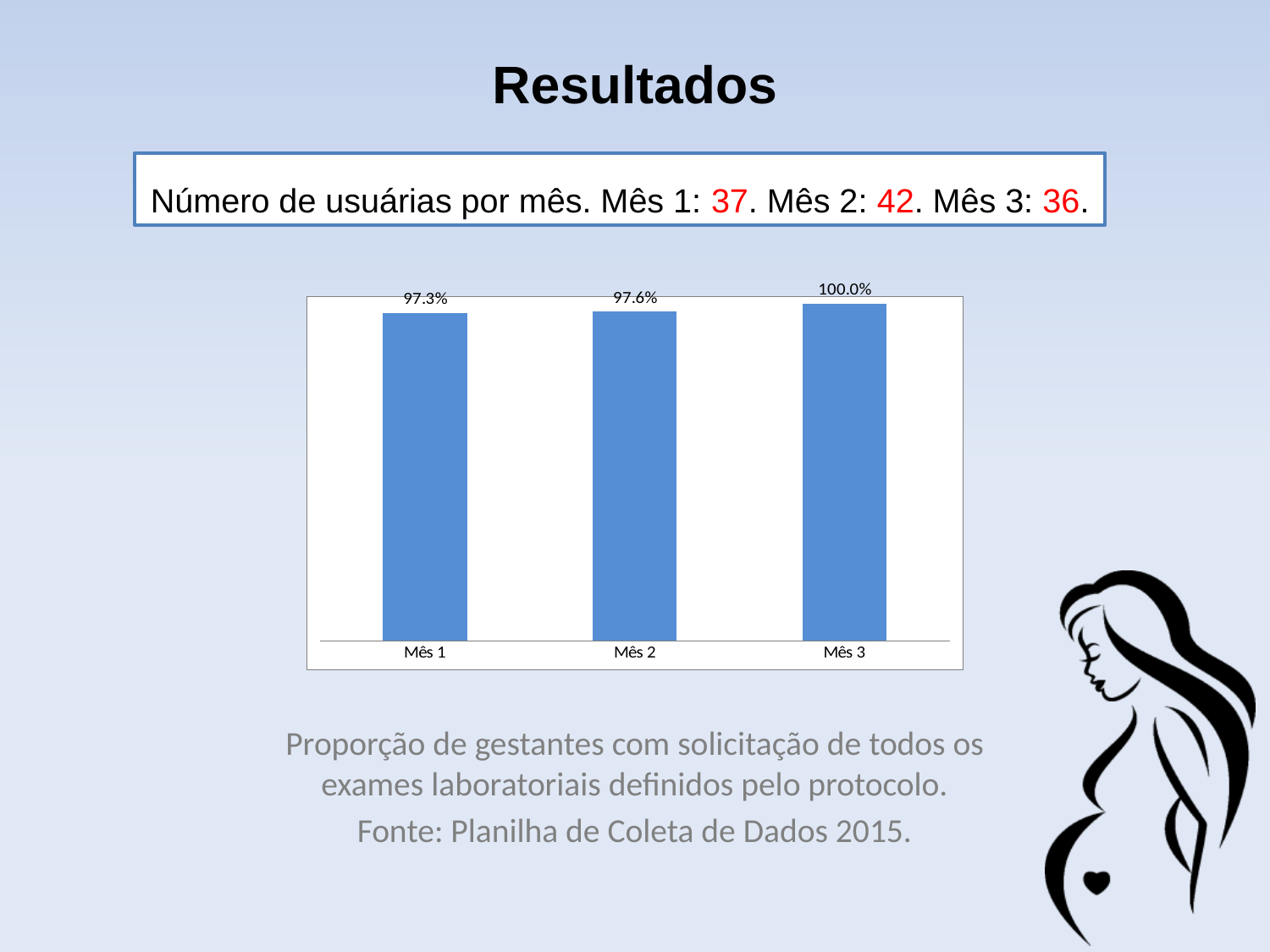
Which month has the lowest value in the chart? Mês 1 Do the values rise or fall from Mês 1 to Mês 3? Rise What is the difference between the values for Mês 2 and Mês 1? 0.3 percentage points What is the difference between the values for Mês 3 and Mês 1? 2.7 percentage points What kind of chart is shown on the slide? Bar chart What is the value shown for Mês 2? 97.6% What is the value shown for Mês 1? 97.3% Which is larger, the value for Mês 3 or the value for Mês 1? Mês 3 What source is cited below the chart? Planilha de Coleta de Dados 2015 Which month has the highest value in the chart? Mês 3 How many months (categories) are plotted in the chart? 3 What is the value shown for Mês 3? 100.0%